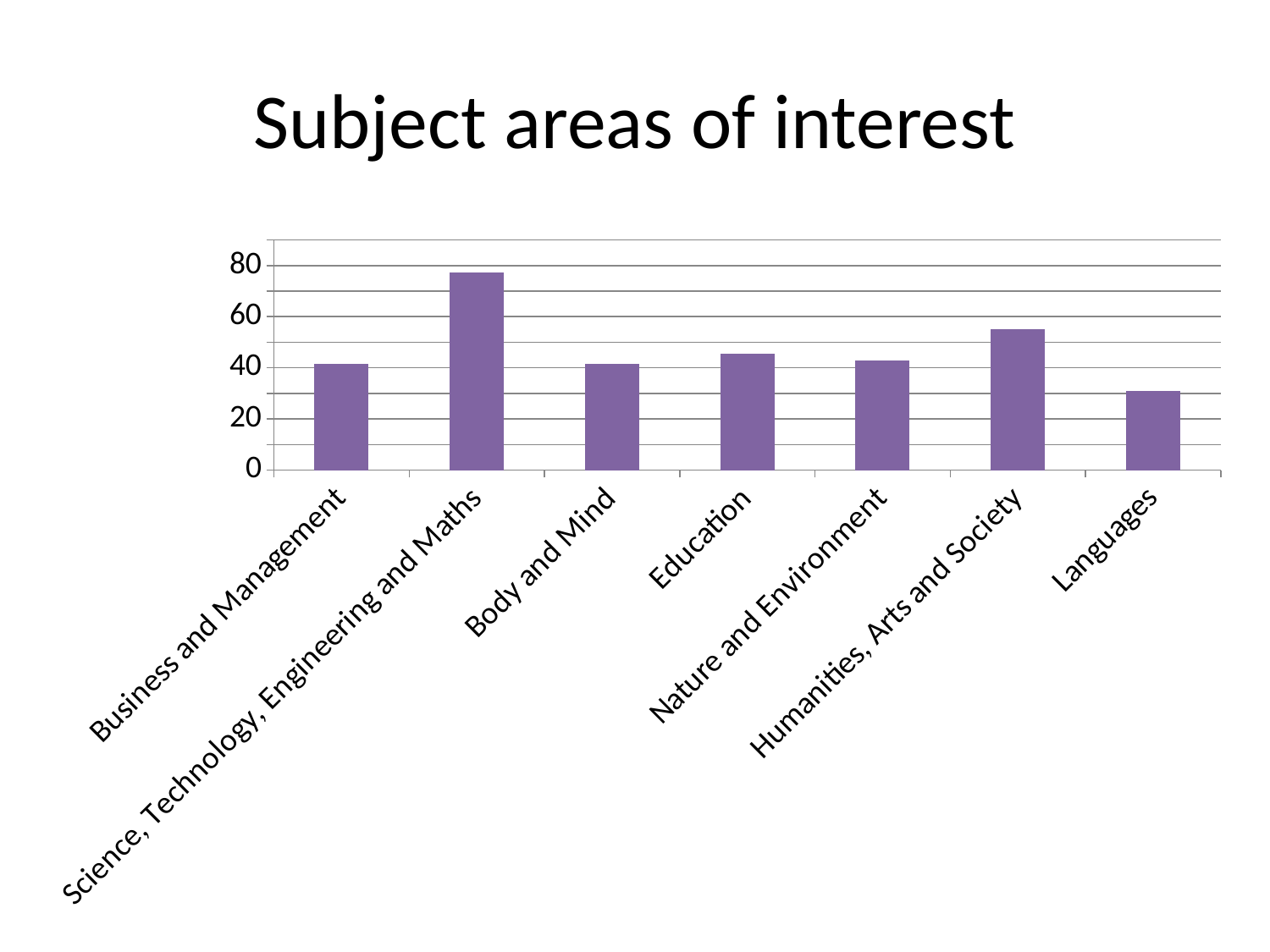
What is the title of the slide? Subject areas of interest Which subject area has the highest bar? Science, Technology, Engineering and Maths What colour are the bars in the chart? purple Is the value for Languages greater or less than 40? less Which is larger, the value for Humanities, Arts and Society or the value for Education? Humanities, Arts and Society How many subject areas are shown on the x axis? 7 What kind of chart is shown on the slide? bar chart Is the value for Education greater or less than 40? greater Which is larger, the value for Languages or the value for Body and Mind? Body and Mind Which subject area has the lowest bar? Languages Is the value for Humanities, Arts and Society greater or less than 60? less